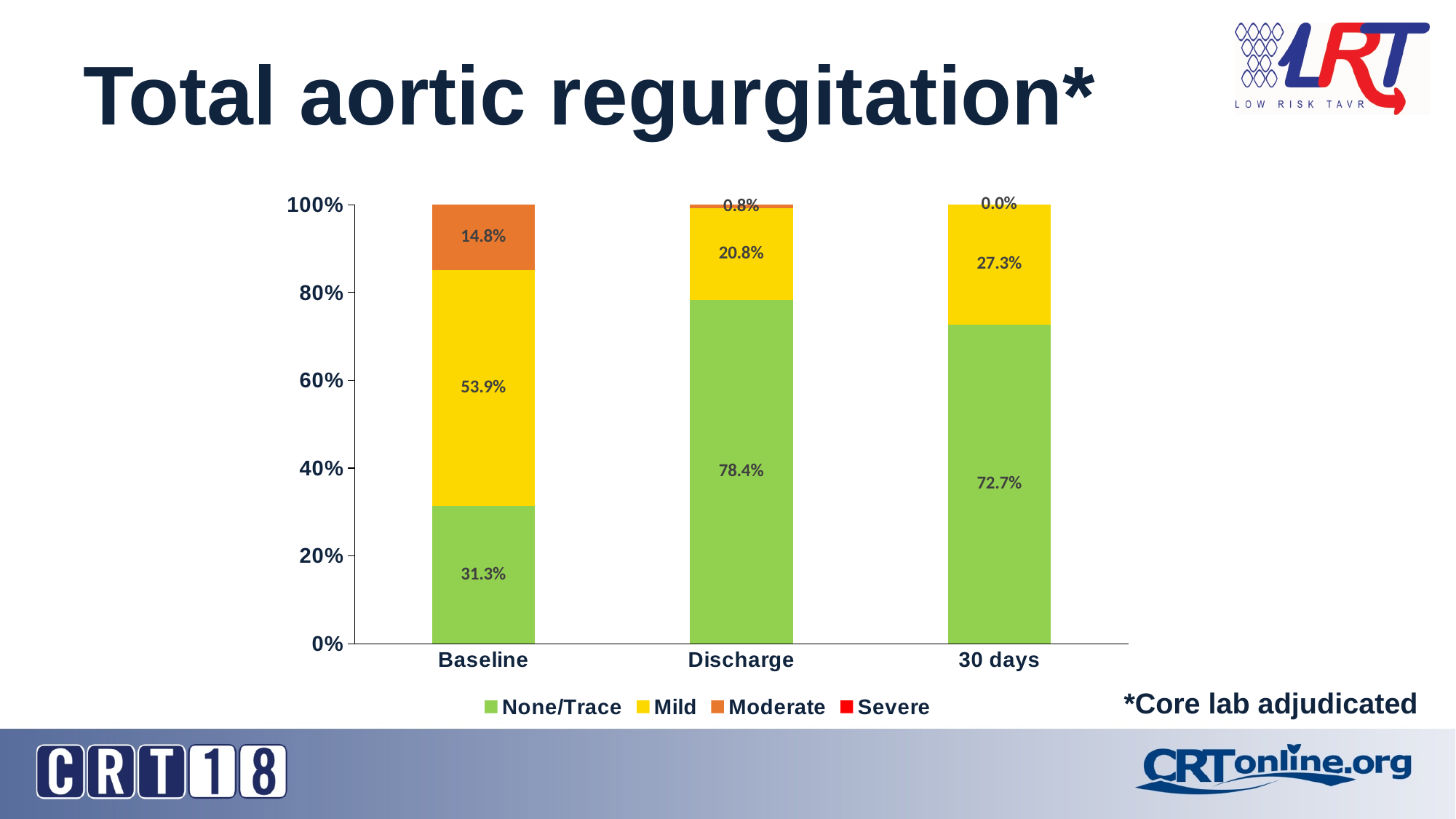
What is the None/Trace value at Baseline? 31.3% What is the Moderate value at Discharge? 0.8% What is the Moderate value at Baseline? 14.8% What is the Mild value at Discharge? 20.8% At which time point is the None/Trace value highest? Discharge Which is larger: the Mild value at Baseline or the Mild value at 30 days? Baseline How many series does the legend list? 4 What is the difference between the None/Trace values at Discharge and Baseline? 47.1% At which time point is the Mild value lowest? Discharge What is the Mild value at 30 days? 27.3% How many time points are shown on the x axis? 3 What kind of chart is shown on the slide? Stacked bar chart